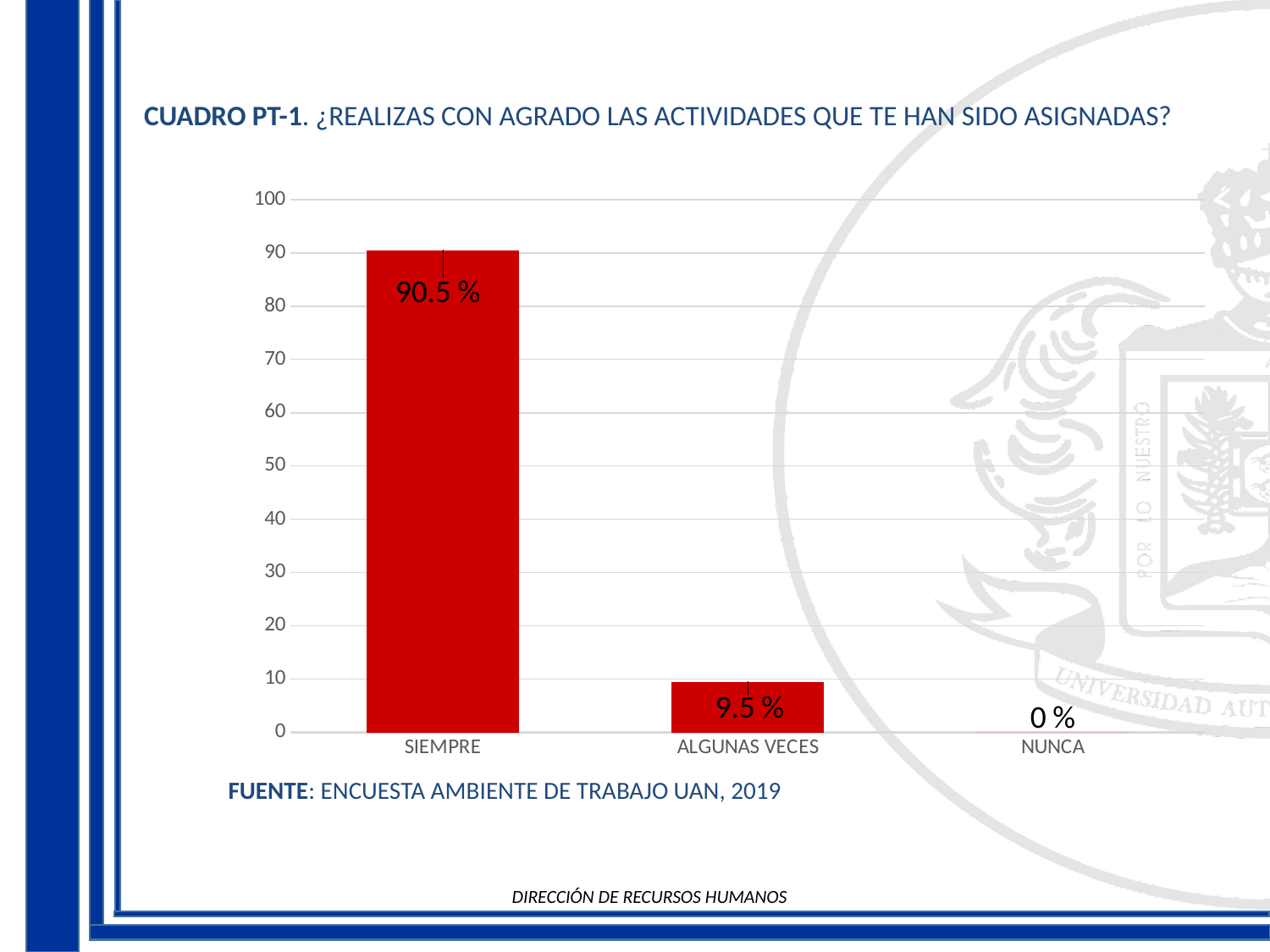
Is the value for ALGUNAS VECES greater or less than 20? less What is the difference between the values for SIEMPRE and ALGUNAS VECES? 81 % What is the value for SIEMPRE? 90.5 % Which is larger, the value for ALGUNAS VECES or the value for NUNCA? ALGUNAS VECES What is the value for NUNCA? 0 % How many categories are shown on the x axis? 3 What is the source cited below the chart? ENCUESTA AMBIENTE DE TRABAJO UAN, 2019 Which category has the highest value? SIEMPRE What is the value for ALGUNAS VECES? 9.5 % Which category has the lowest value? NUNCA Is the value for SIEMPRE greater or less than 80? greater What kind of chart is shown on the slide? bar chart